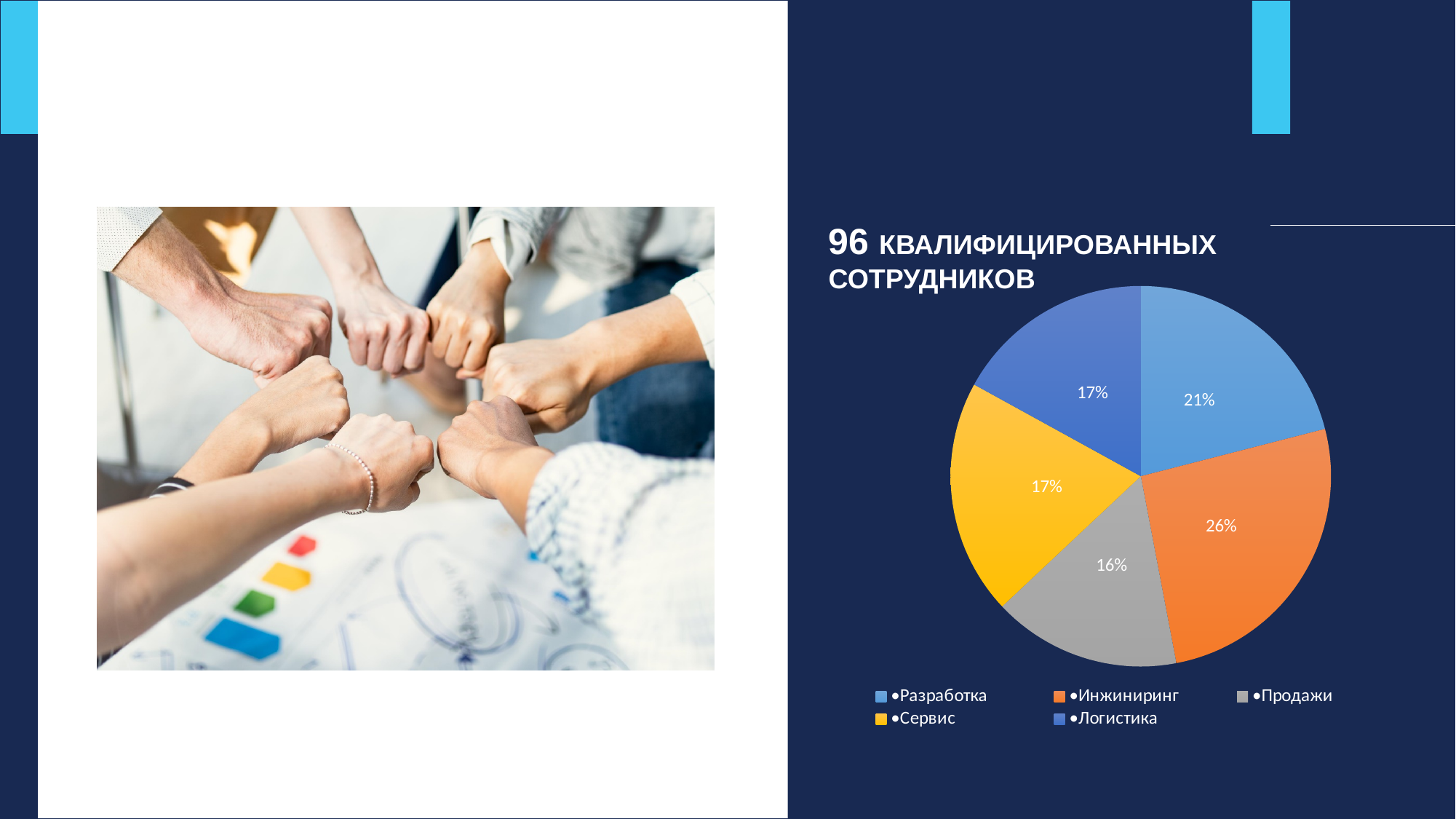
What type of chart is shown on the slide? Pie chart Which category has the smallest slice of the pie chart? Продажи Which category has the largest slice of the pie chart? Инжиниринг What percentage of the pie chart is labelled for Инжиниринг? 26% How many categories are shown in the pie chart? 5 What share of the pie does the Логистика slice represent? 17% What percentage is shown for the Продажи slice? 16% What is the difference in percentage points between the Инжиниринг and Разработка slices? 5 What percentage is shown for the Разработка slice? 21% What colour is the Сервис slice in the pie chart? Yellow Which slice is larger, Разработка or Продажи? Разработка What percentage is shown for the Сервис slice? 17%